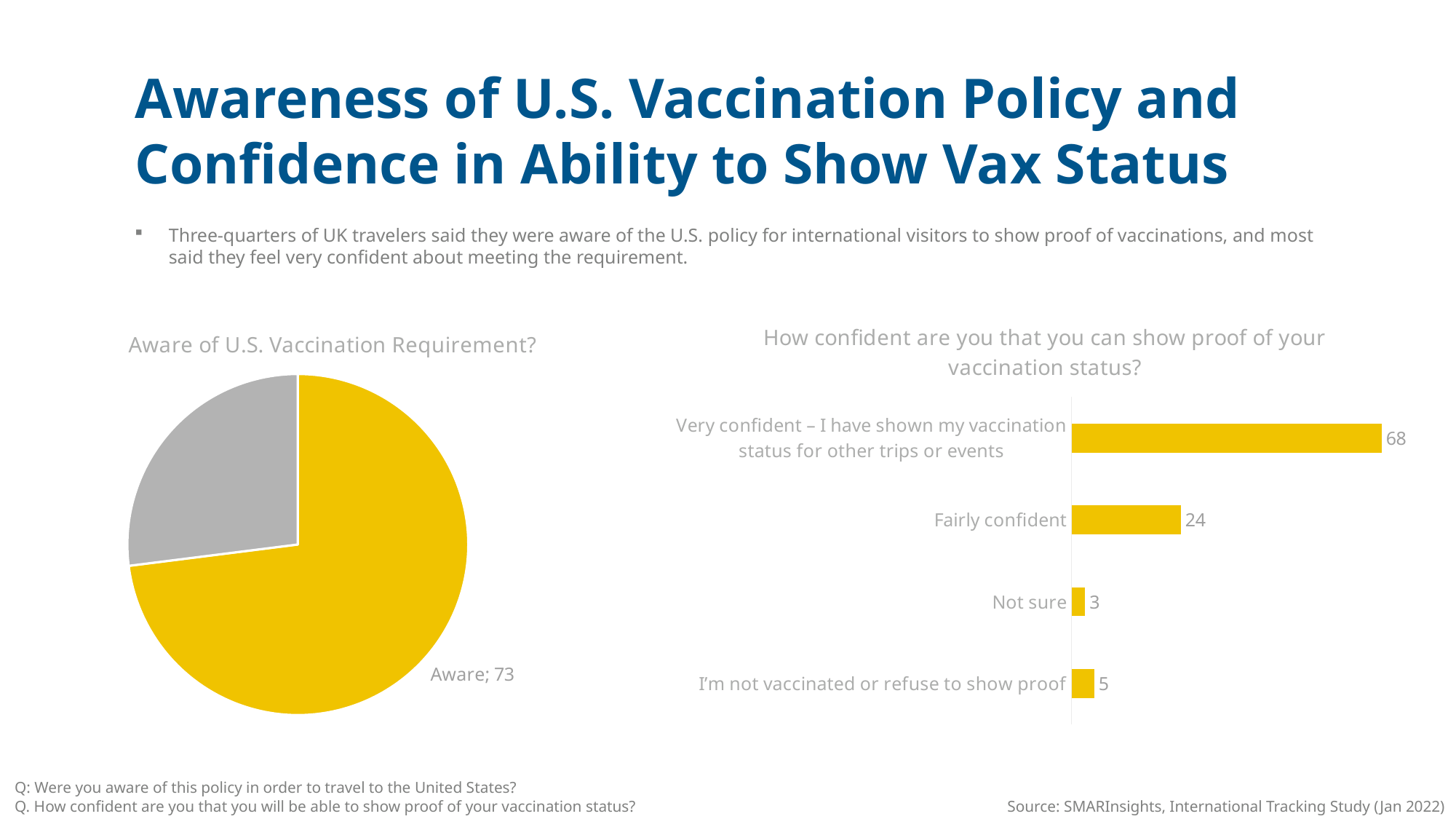
In the 'How confident are you that you can show proof of your vaccination status?' chart, which category has the lowest value? Not sure In the 'How confident are you that you can show proof of your vaccination status?' chart, which is larger: Not sure or 'I'm not vaccinated or refuse to show proof'? I'm not vaccinated or refuse to show proof In the 'Aware of U.S. Vaccination Requirement?' chart, what is the value for the Aware slice? 73 In the 'Aware of U.S. Vaccination Requirement?' pie chart, what colour is the Aware slice? yellow What kind of chart is the 'Aware of U.S. Vaccination Requirement?' chart? pie chart In the 'How confident are you that you can show proof of your vaccination status?' chart, what is the value for Not sure? 3 What kind of chart is the 'How confident are you that you can show proof of your vaccination status?' chart? bar chart How many categories are shown in the 'How confident are you that you can show proof of your vaccination status?' chart? 4 In the 'How confident are you that you can show proof of your vaccination status?' chart, what is the difference between the Very confident value and the Fairly confident value? 44 In the 'How confident are you that you can show proof of your vaccination status?' chart, which category has the highest value? Very confident – I have shown my vaccination status for other trips or events In the 'How confident are you that you can show proof of your vaccination status?' chart, what is the value for Fairly confident? 24 In the 'How confident are you that you can show proof of your vaccination status?' chart, what is the value for 'I'm not vaccinated or refuse to show proof'? 5